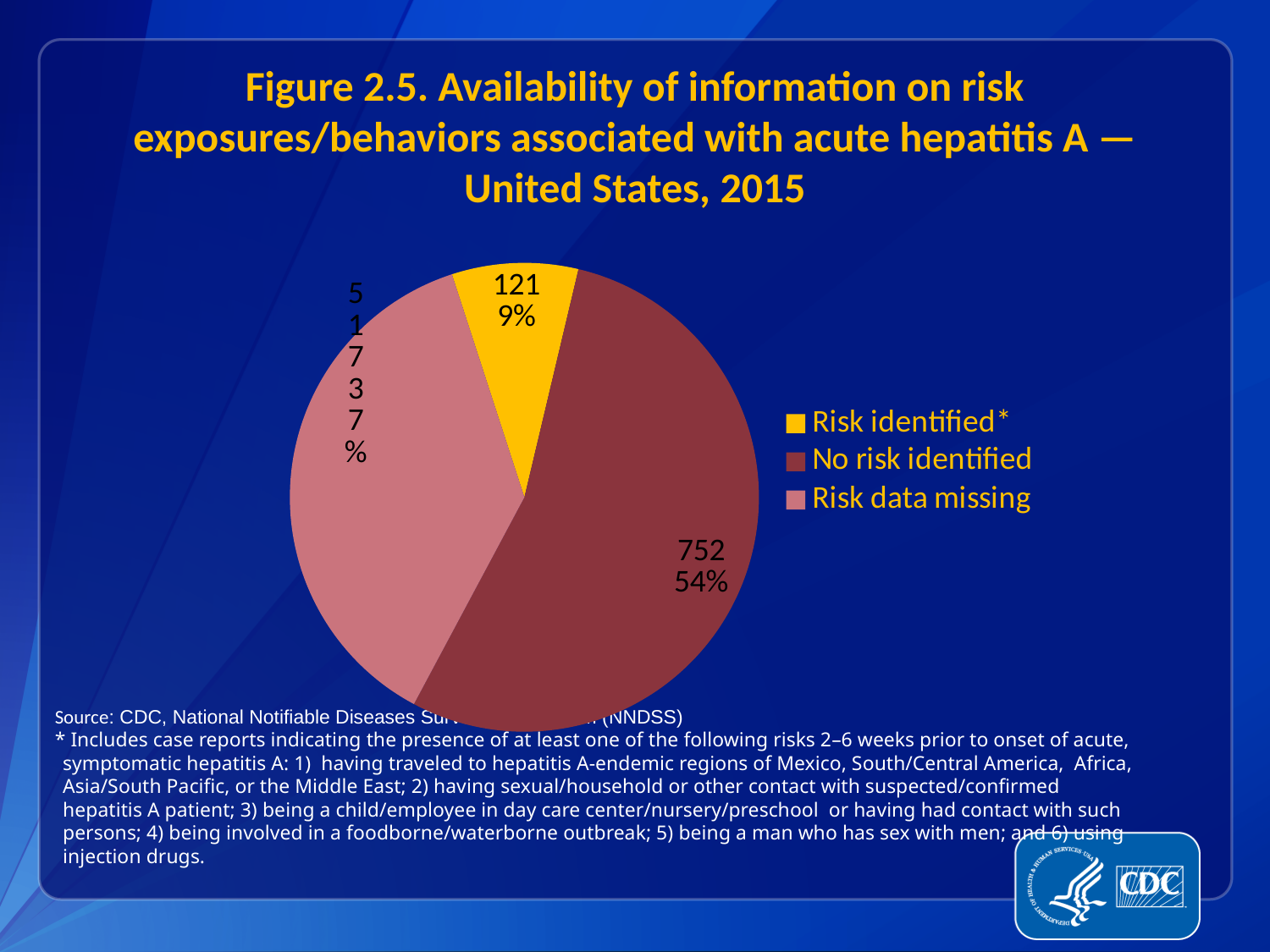
What kind of chart is shown on the slide? Pie chart Which category has the largest slice of the pie? No risk identified What percentage of the pie is the 'Risk identified*' slice? 9% How many slices does the pie chart have? 3 Which is larger, the 'Risk data missing' slice or the 'Risk identified*' slice? Risk data missing How many cases are in the 'No risk identified' slice? 752 Which category has the smallest slice of the pie? Risk identified* What colour is the 'Risk identified*' slice? Yellow How many cases are in the 'Risk identified*' slice? 121 How many entries does the legend list? 3 What is the difference between the number of cases with no risk identified and the number with a risk identified? 631 How many cases are in the 'Risk data missing' slice? 517